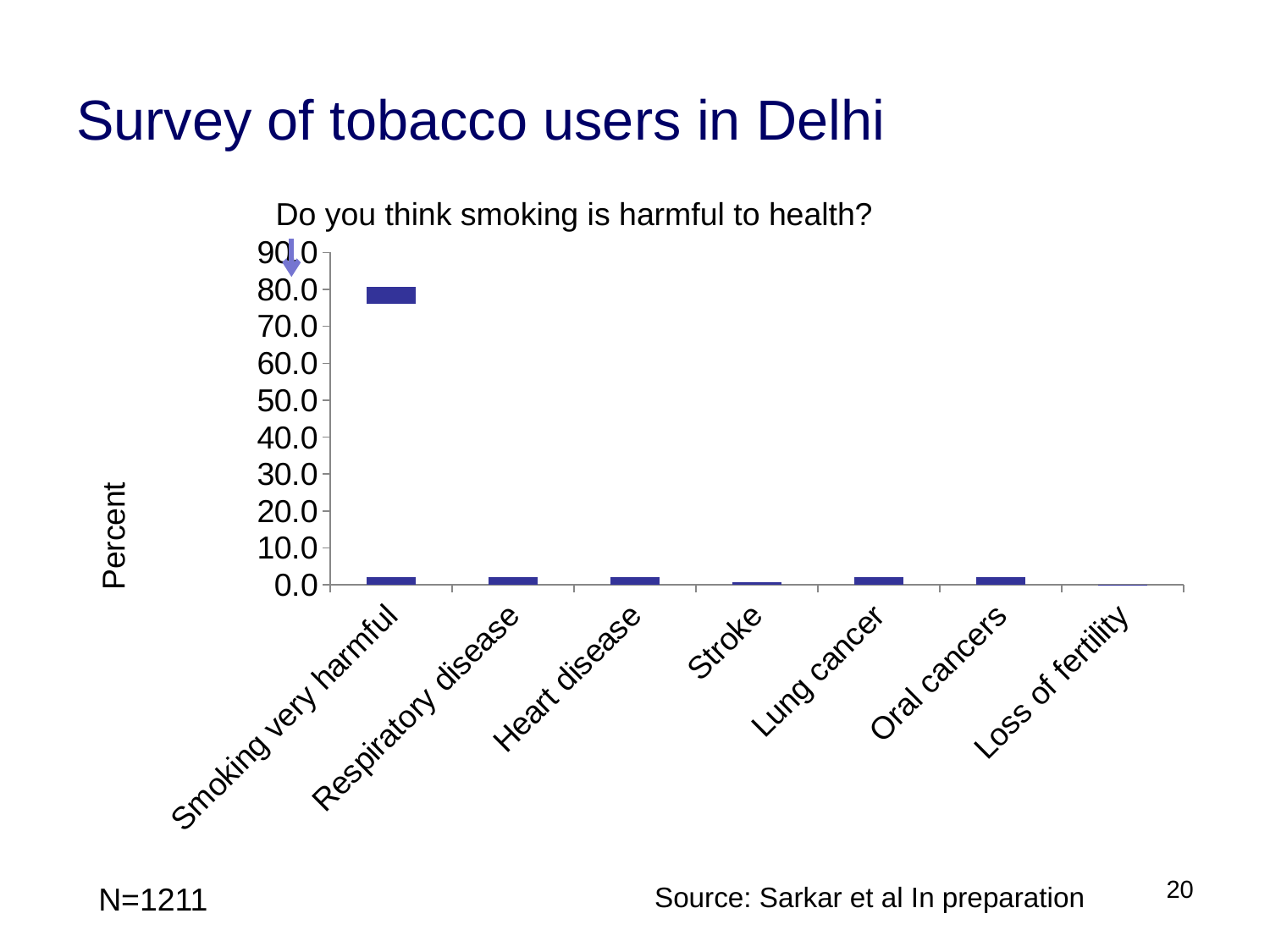
Is the value for Lung cancer greater or less than 10.0? less Which category has the highest value in the chart? Smoking very harmful Which is larger, the value for Stroke or the value for Smoking very harmful? Smoking very harmful Is the value for Respiratory disease greater or less than 10.0? less What is the title of the chart? Do you think smoking is harmful to health? What is the label on the y axis of the chart? Percent What kind of chart is shown on the slide? bar chart Is the value for Smoking very harmful greater or less than 50.0? greater How many categories are shown on the x axis of the chart? 7 Which is larger, the value for Smoking very harmful or the value for Oral cancers? Smoking very harmful